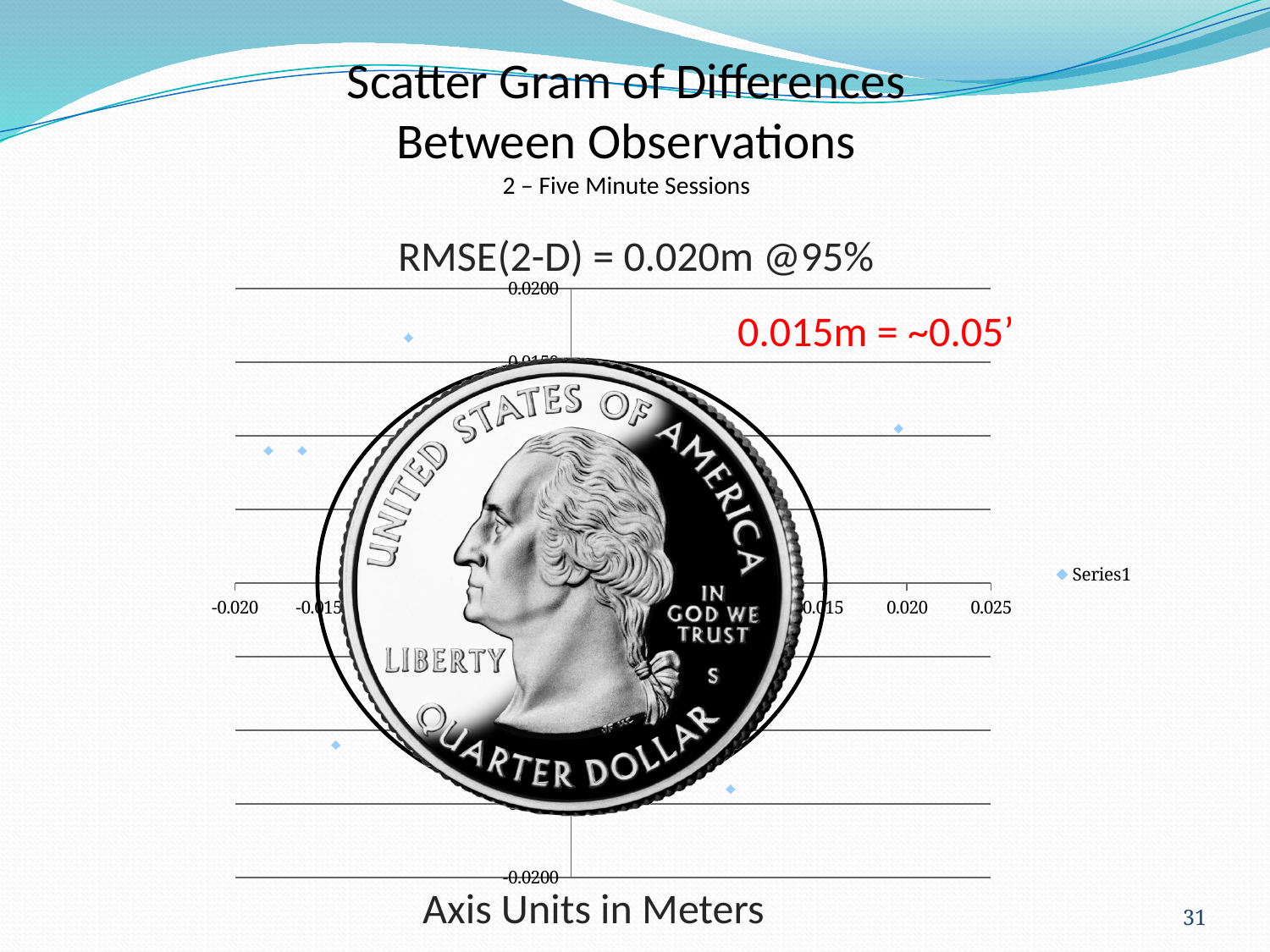
What is the title of the chart? RMSE(2-D) = 0.020m @95% Is the x value of the leftmost point in the scatter chart greater or less than -0.015? less What is the maximum value shown on the chart's x axis? 0.025 What kind of chart is shown on the slide? scatter chart What is the minimum value shown on the chart's y axis? -0.0200 What is the name of the series shown in the chart legend? Series1 Is the y value of the lowest point in the scatter chart greater or less than -0.0100? less Is the y value of the highest point in the scatter chart greater or less than 0.0150? greater How many series does the chart legend list? 1